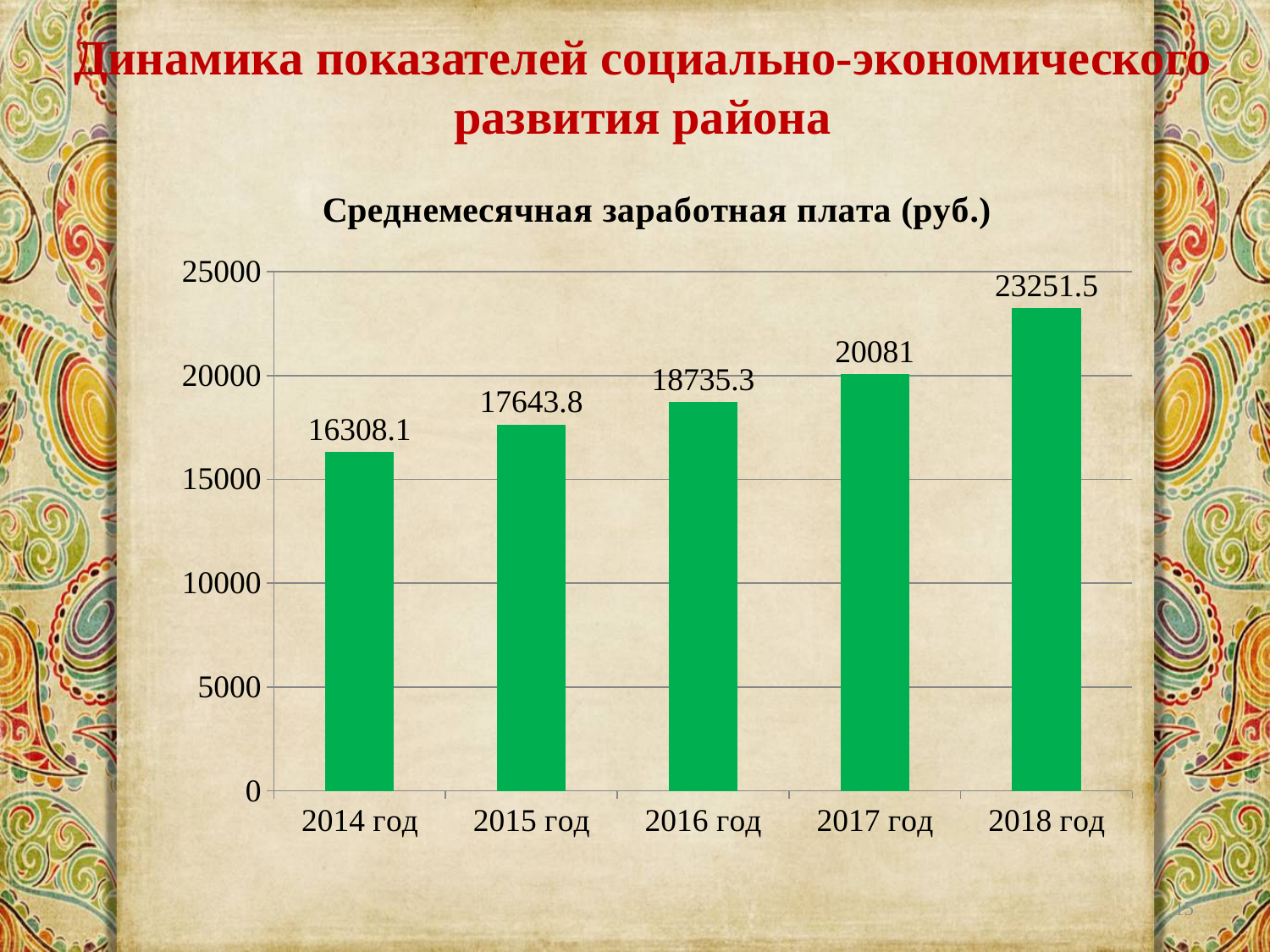
What value is shown for 2017 год in the chart? 20081 Which year has the highest average monthly salary? 2018 год Which is larger, the value for 2016 год or the value for 2015 год? 2016 год By how much did the average monthly salary increase from 2017 год to 2018 год? 3170.5 What is the value for 2016 год? 18735.3 What kind of chart is used to show the average monthly salary? bar chart What is the difference between the values for 2015 год and 2014 год? 1335.7 Is the value for 2017 год greater or less than 20000? greater How many years are shown on the x axis of the chart? 5 What is the average monthly salary shown for 2014 год? 16308.1 Do the values rise or fall from 2014 год to 2018 год? rise Which year has the lowest average monthly salary? 2014 год